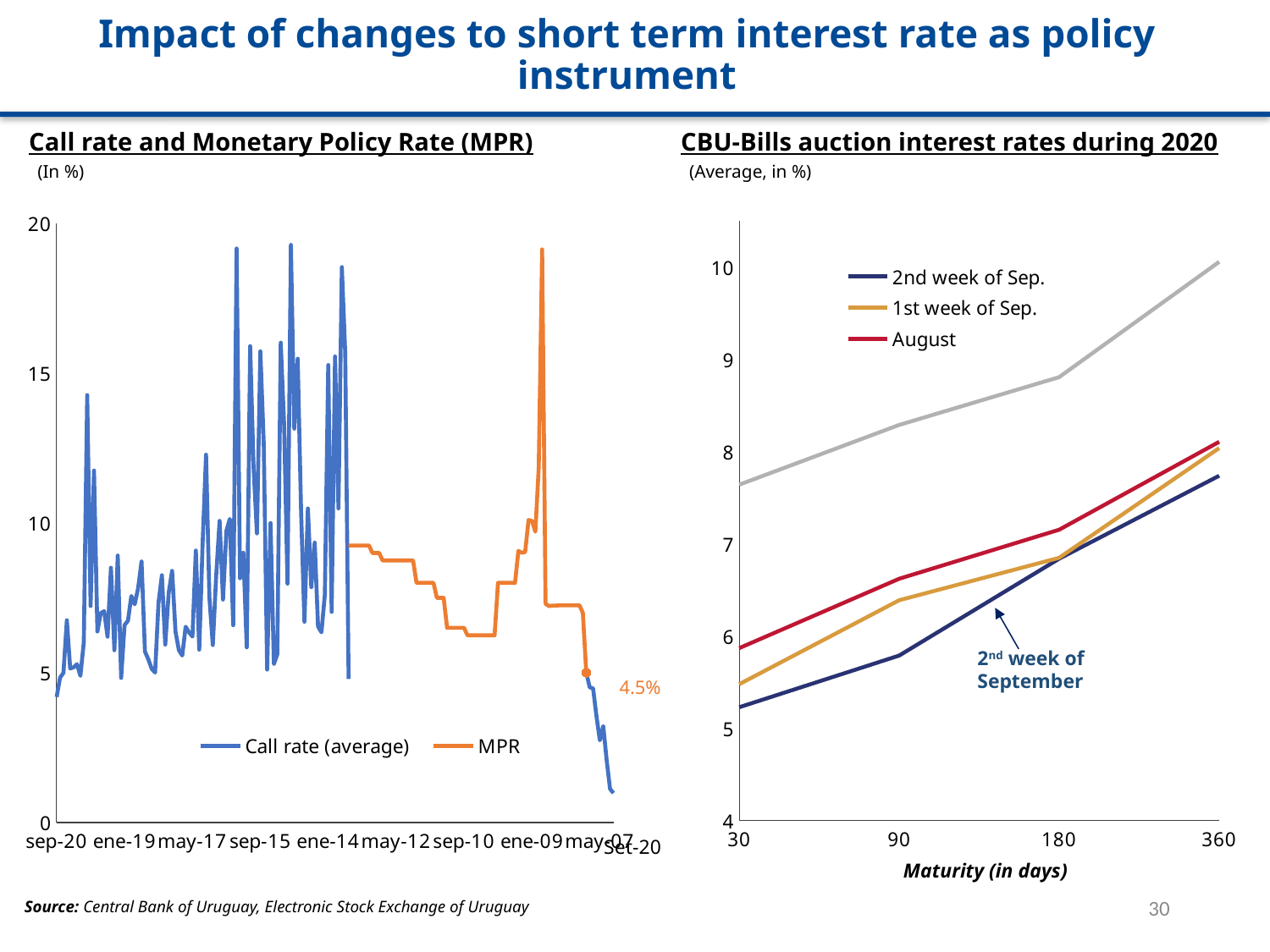
What kind of chart is the 'Call rate and Monetary Policy Rate (MPR)' chart? line chart What is the x-axis title of the 'CBU-Bills auction interest rates during 2020' chart? Maturity (in days) In the 'CBU-Bills auction interest rates during 2020' chart, do the values for '2nd week of Sep.' rise or fall as maturity increases? rise In the 'CBU-Bills auction interest rates during 2020' chart, how many maturity points are shown on the x axis? 4 How many series does the legend of the 'Call rate and Monetary Policy Rate (MPR)' chart list? 2 In the 'CBU-Bills auction interest rates during 2020' chart, is the value for '2nd week of Sep.' at 30 days greater or less than 6? less In the 'CBU-Bills auction interest rates during 2020' chart, is the value for 'August' at 90 days greater or less than 6? greater In the 'CBU-Bills auction interest rates during 2020' chart, at 360 days, which is higher: 'August' or '2nd week of Sep.'? August In the 'CBU-Bills auction interest rates during 2020' chart, which of the three legend series is lowest at a maturity of 30 days? 2nd week of Sep. How many series does the legend of the 'CBU-Bills auction interest rates during 2020' chart list? 3 In the 'CBU-Bills auction interest rates during 2020' chart, which of the three legend series is highest at a maturity of 30 days? August In the 'Call rate and Monetary Policy Rate (MPR)' chart, what value is labelled on the MPR line near the end of the series? 4.5%